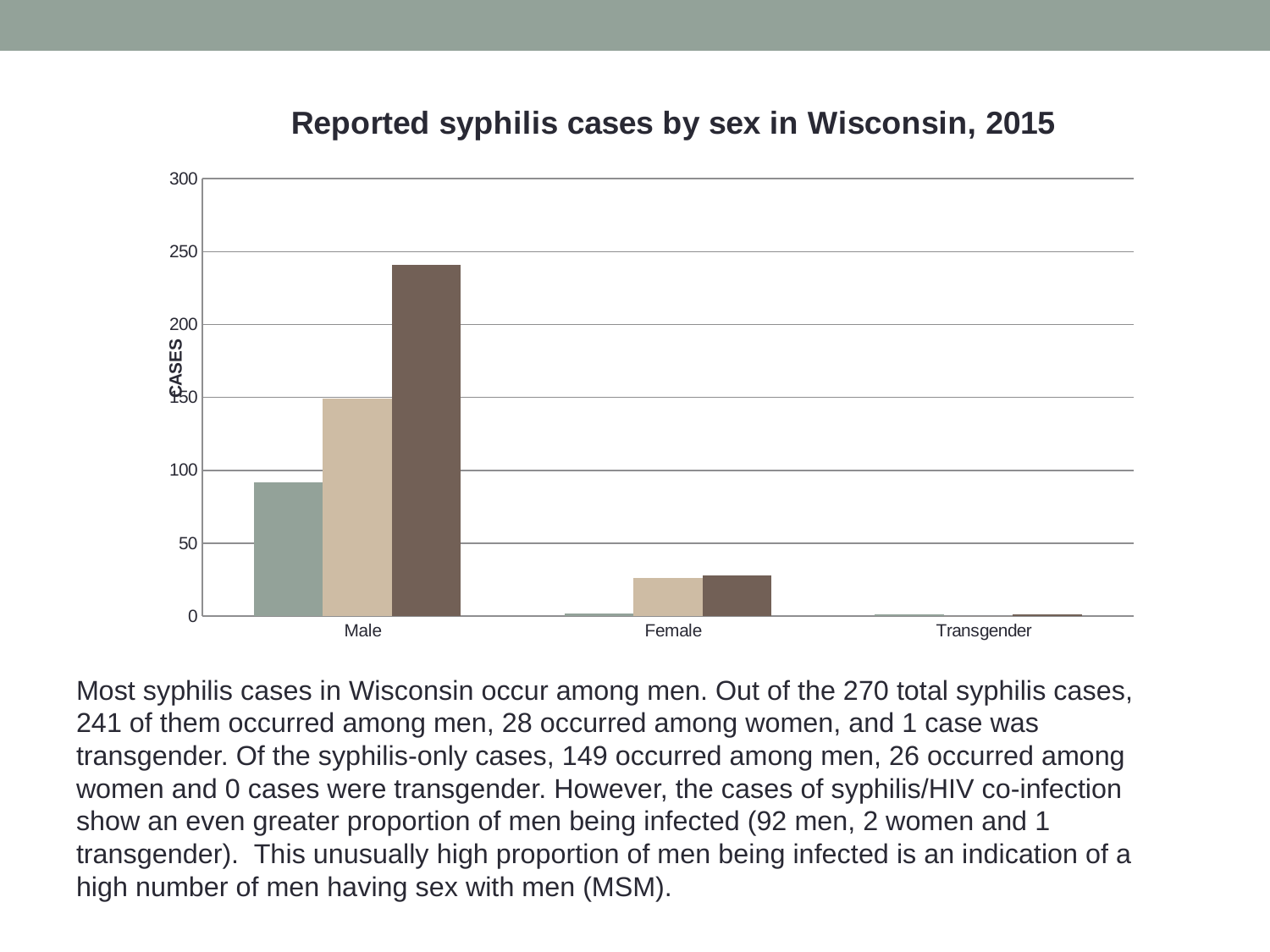
What is the label on the y axis of the chart? CASES Is the value of the dark brown bar for Female greater or less than 50? less Do the bar heights rise or fall moving from Male to Transgender along the x axis? fall Which category has the lowest bars in the chart? Transgender How many categories are shown on the x axis of the chart? 3 Is the value of the dark brown bar for Male greater or less than 200? greater What is the title of the chart? Reported syphilis cases by sex in Wisconsin, 2015 Which is larger, the dark brown bar for Male or the dark brown bar for Female? Male Which category has the tallest bar in the chart? Male What kind of chart is shown on the slide? bar chart Is the value of the green bar for Male greater or less than 100? less